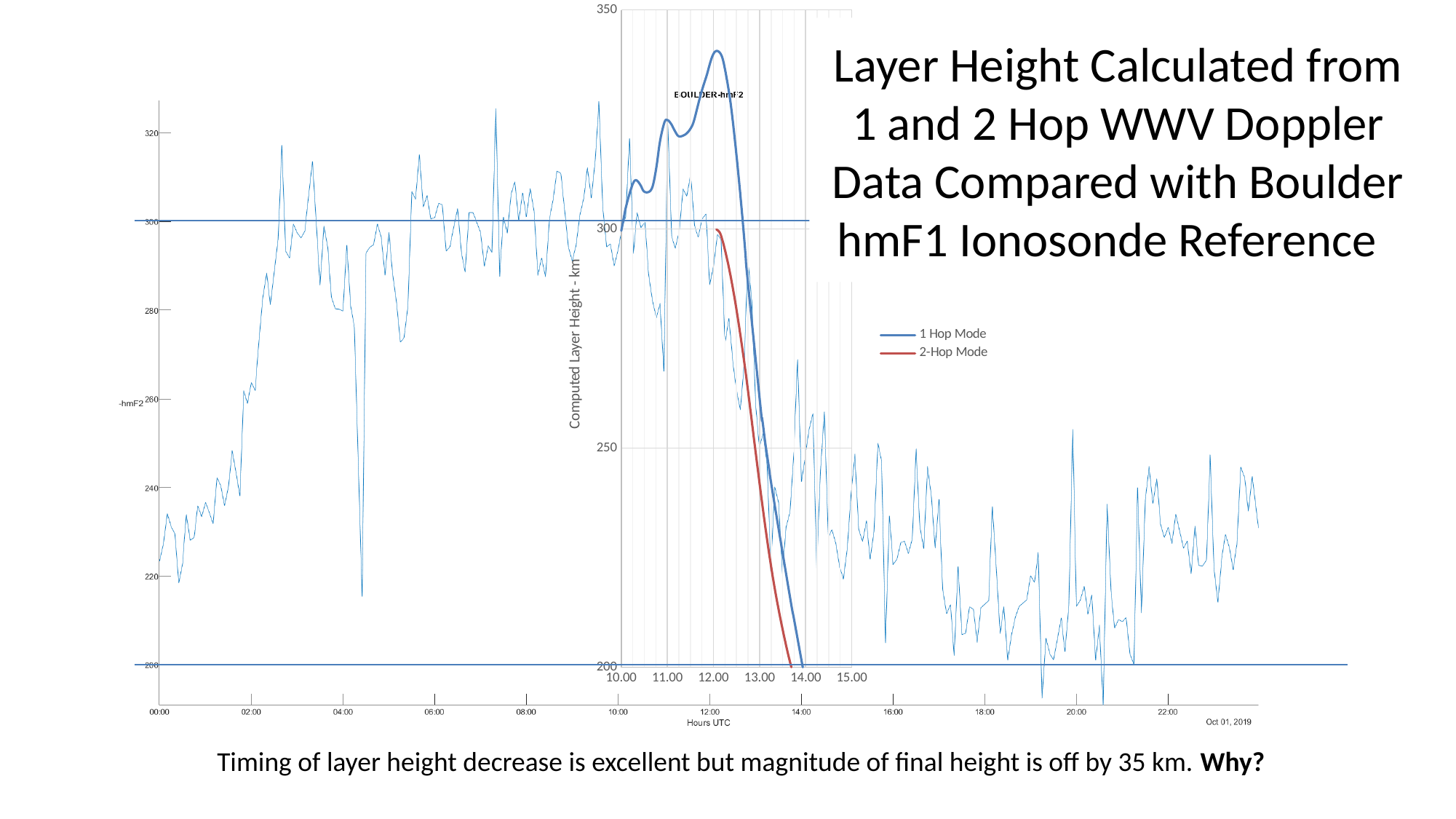
What colour is the 2-Hop Mode line in the Computed Layer Height chart? red In the Computed Layer Height chart, does the 1 Hop Mode line rise or fall between 12.00 and 14.00? fall In the Computed Layer Height chart, is the 1 Hop Mode value at 13.00 greater or less than 250? greater In the Computed Layer Height chart, is the 1 Hop Mode value at 10.00 greater or less than 350? less In the Computed Layer Height chart, is the 2-Hop Mode value at 13.00 greater or less than 300? less What are the two series named in the legend of the Computed Layer Height chart? 1 Hop Mode and 2-Hop Mode What kind of chart is the overlaid Computed Layer Height chart? line chart In the Computed Layer Height chart, which series reaches the higher peak value, 1 Hop Mode or 2-Hop Mode? 1 Hop Mode How many series does the legend of the Computed Layer Height chart list? 2 In the Computed Layer Height chart, which series reaches 200 km first, 1 Hop Mode or 2-Hop Mode? 2-Hop Mode